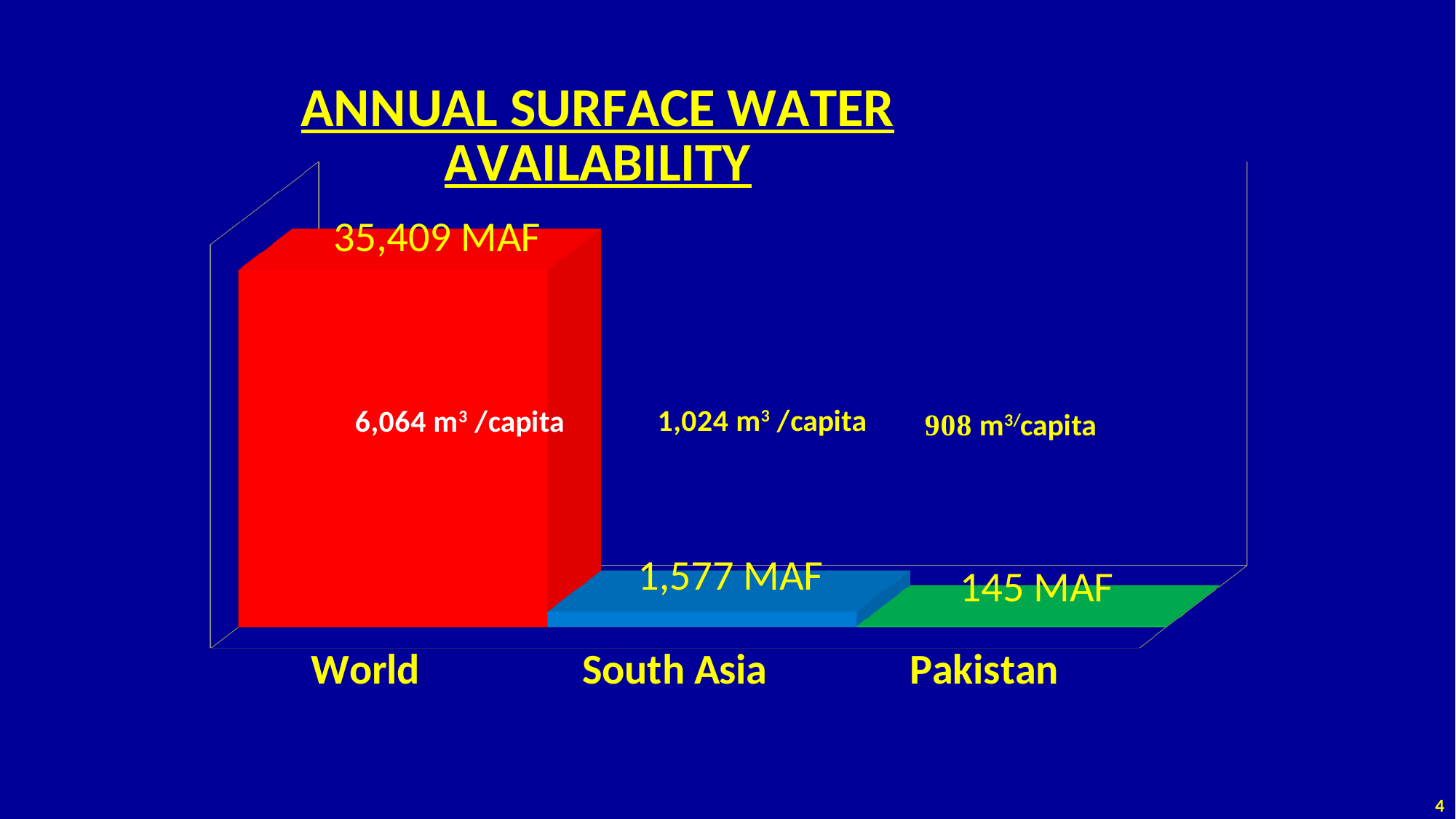
What is the title of the chart? ANNUAL SURFACE WATER AVAILABILITY What is the per capita surface water availability shown for Pakistan? 908 m³/capita What is the difference in MAF between South Asia and Pakistan? 1,432 MAF Which has a larger annual surface water availability, South Asia or Pakistan? South Asia What is the annual surface water availability for the World? 35,409 MAF What is the annual surface water availability for South Asia? 1,577 MAF What is the annual surface water availability for Pakistan? 145 MAF What is the per capita surface water availability shown for the World? 6,064 m³/capita What kind of chart is shown on the slide? Bar chart Which category has the highest annual surface water availability? World Which category has the lowest annual surface water availability? Pakistan How many categories are shown in the chart? 3